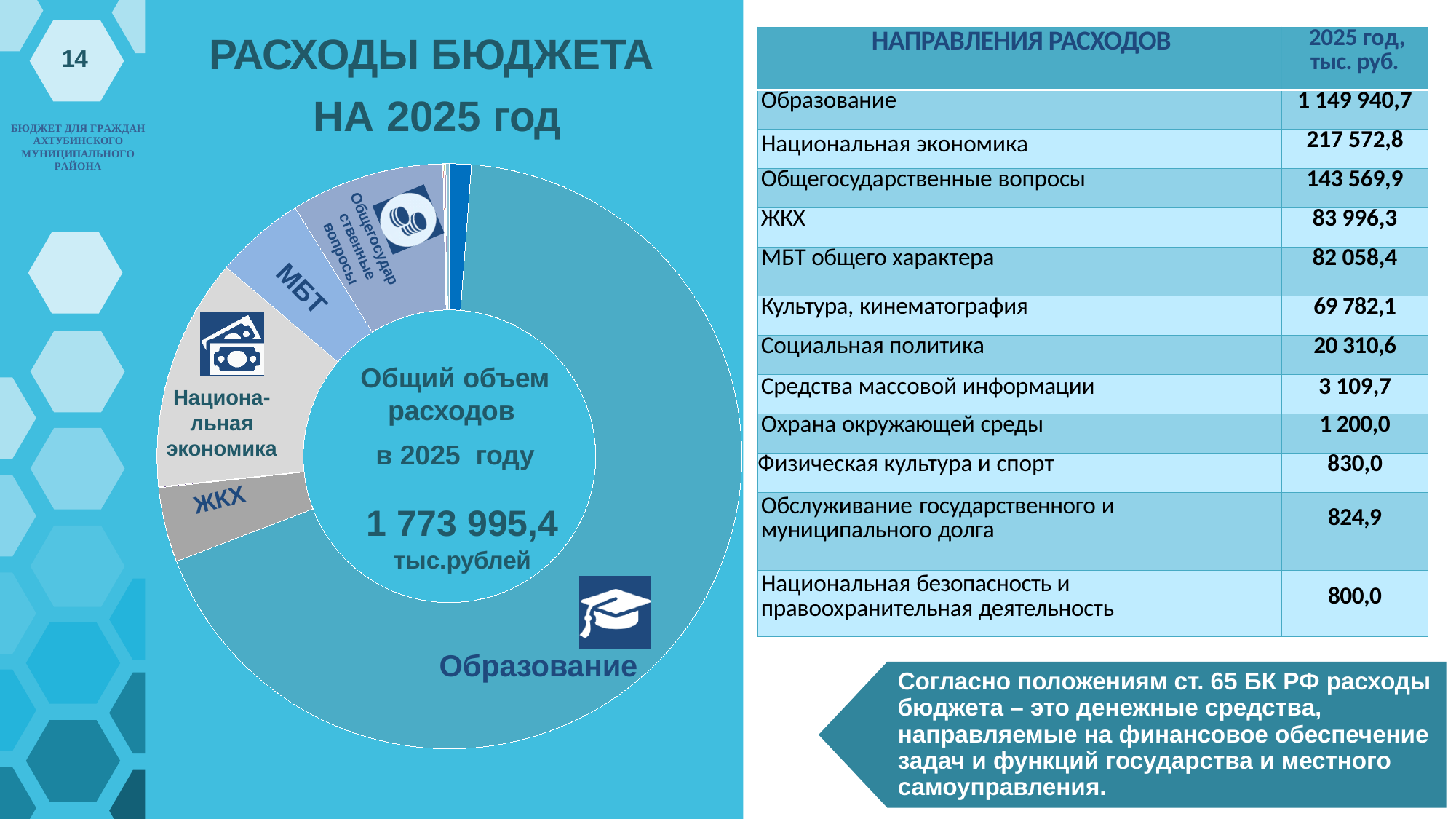
What total expenditure volume for 2025 is printed in the centre of the doughnut chart? 1 773 995,4 тыс.рублей Which slice is larger in the doughnut chart: Национальная экономика or ЖКХ? Национальная экономика Which category has the largest slice in the doughnut chart? Образование What is the title of the chart on the slide? РАСХОДЫ БЮДЖЕТА НА 2025 год According to the table on the slide, what is the 2025 value for Образование, тыс. руб.? 1 149 940,7 According to the table on the slide, what is the difference between Национальная экономика (217 572,8) and Общегосударственные вопросы (143 569,9), тыс. руб.? 74 002,9 Which slice of the doughnut chart is marked with a graduation cap icon? Образование Which slice is larger in the doughnut chart: Образование or ЖКХ? Образование According to the table on the slide, what is the 2025 value for ЖКХ, тыс. руб.? 83 996,3 What kind of chart is shown on the slide? Doughnut (pie) chart According to the table on the slide, what is the 2025 value for Национальная экономика, тыс. руб.? 217 572,8 Which slice is larger in the doughnut chart: Общегосударственные вопросы or МБТ? Общегосударственные вопросы